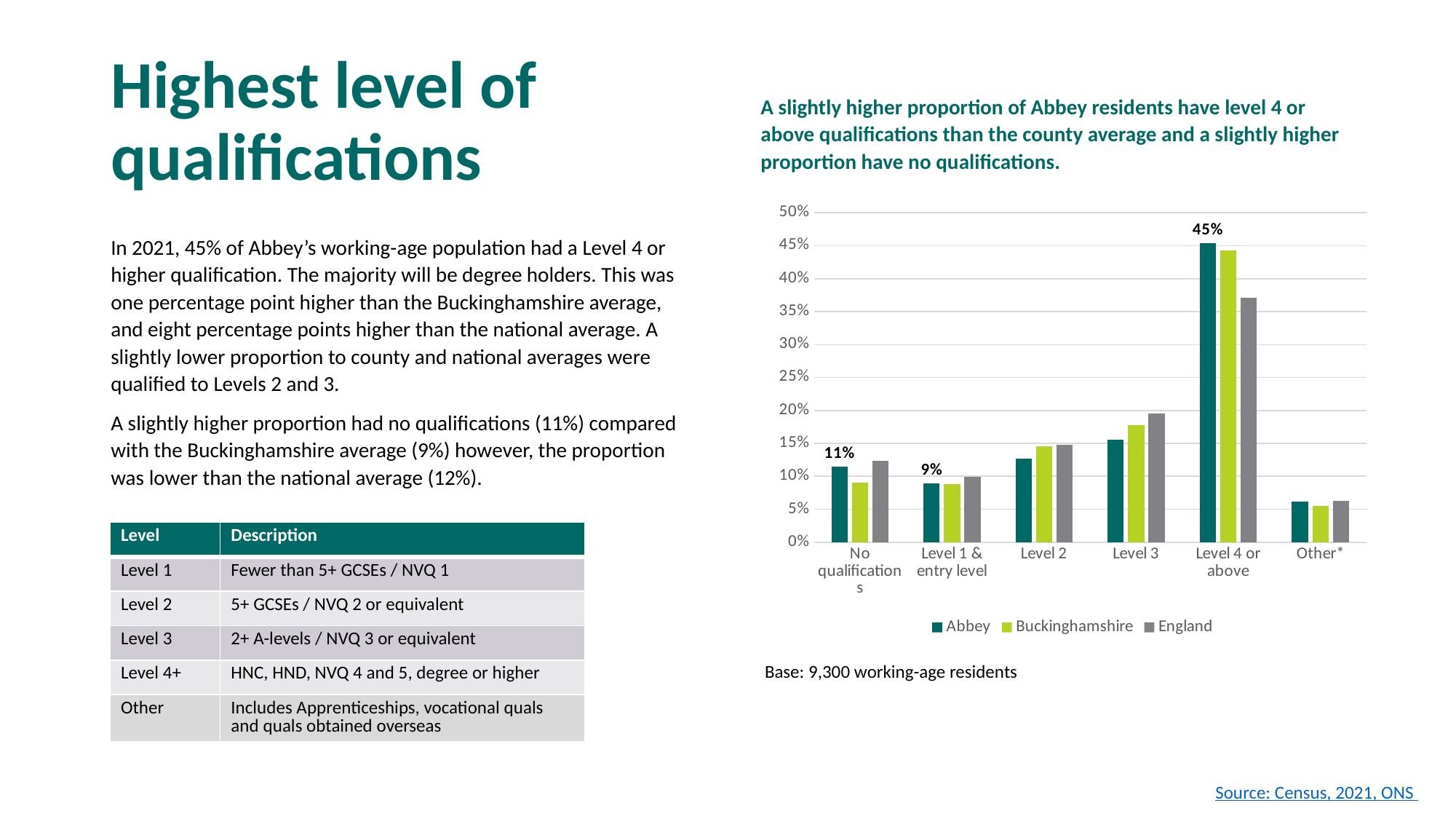
Is the value for England in 'Level 4 or above' greater or less than 40%? less For 'Level 4 or above', which is larger: the Abbey value or the England value? Abbey What kind of chart is shown on the slide? Bar chart How many series does the legend list? 3 What is the value for Abbey in the 'Level 1 & entry level' category? 9% What is the difference between Abbey's 'Level 4 or above' value and its 'No qualifications' value? 34 percentage points What is the value for Abbey in the 'Level 4 or above' category? 45% Which category has the highest value for the Abbey series? Level 4 or above What is the value for Abbey in the 'No qualifications' category? 11% How many qualification categories are shown on the x axis? 6 For 'Level 3', which is larger: the Abbey value or the England value? England Which category has the lowest value for the Abbey series? Other*